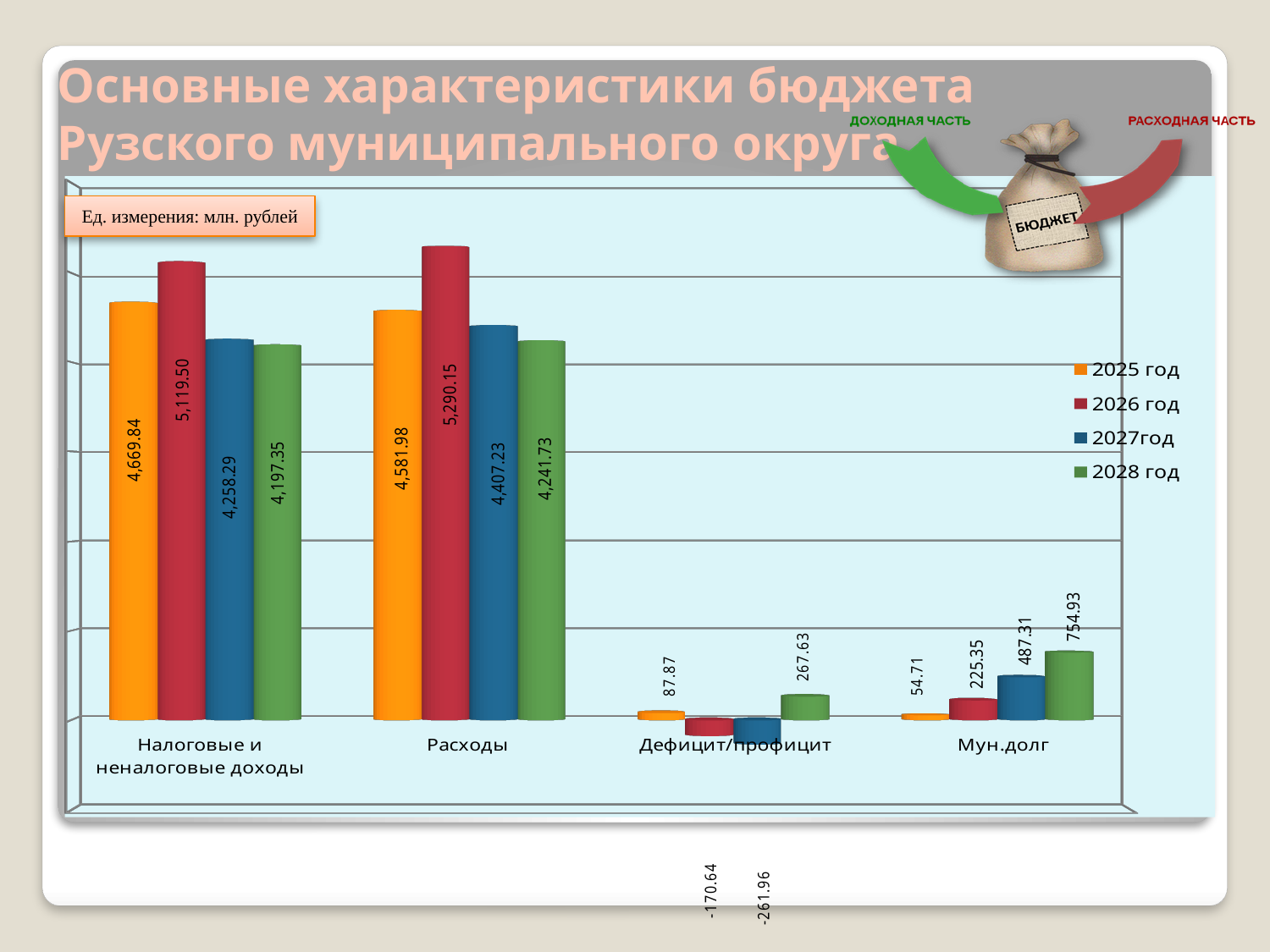
What is the value for 2027год in the Дефицит/профицит category? -261.96 What is the value for 2025 год in the Налоговые и неналоговые доходы category? 4,669.84 Which year has the lowest value in the Налоговые и неналоговые доходы category? 2028 год What is the value for 2026 год in the Расходы category? 5,290.15 Which year has the highest value in the Мун.долг category? 2028 год How many categories are shown on the x axis of the chart? 4 What kind of chart is shown on the slide? Bar chart Which is larger in the Расходы category: the value for 2027год or the value for 2028 год? 2027год What is the difference between the 2028 год and 2025 год values in the Мун.долг category? 700.22 What is the difference between the 2026 год and 2025 год values in the Мун.долг category? 170.64 What is the value for 2028 год in the Мун.долг category? 754.93 How many series does the legend list? 4